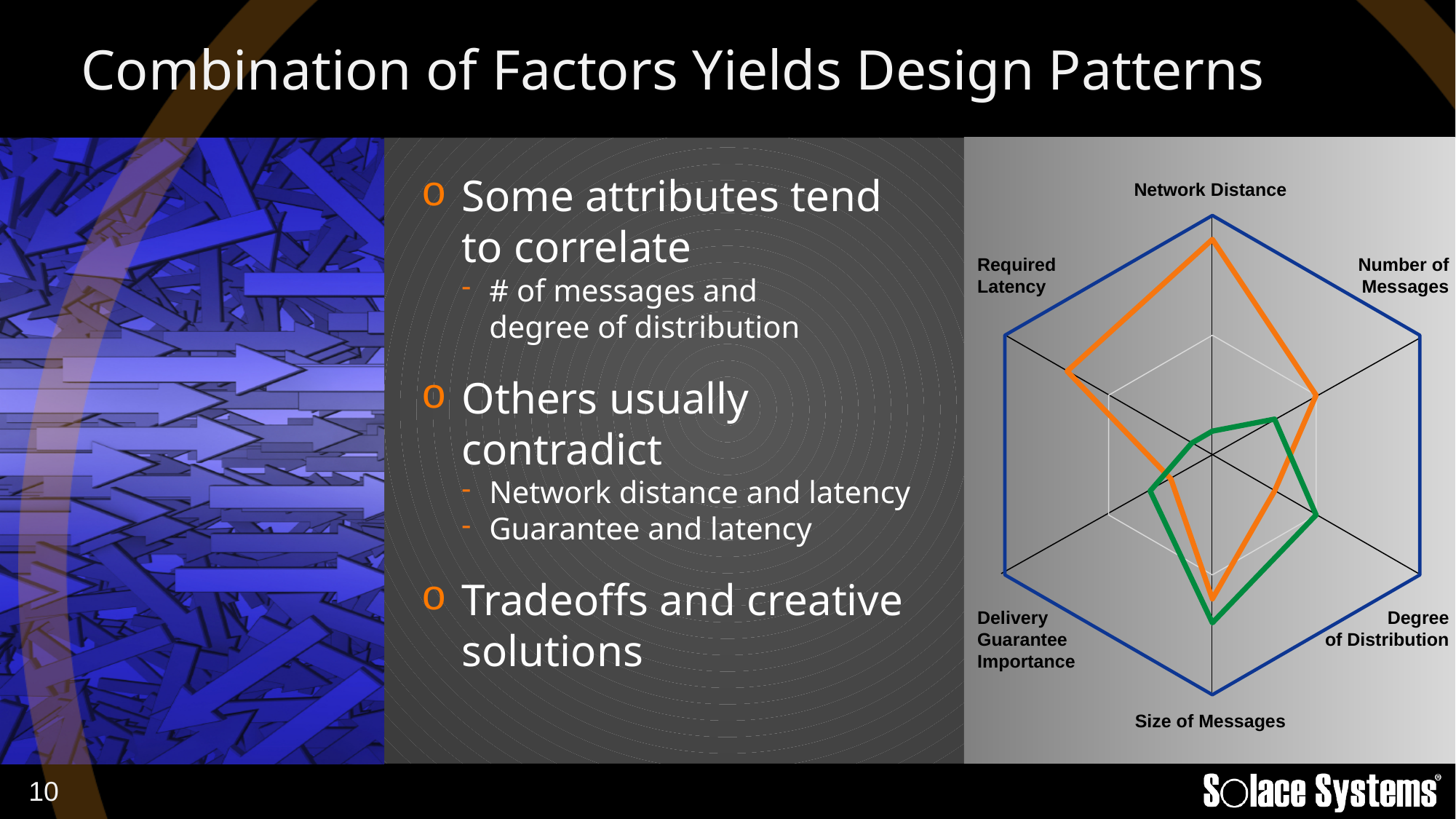
On which axis does the green series have its lowest value? Network Distance and Required Latency (tied) On the Degree of Distribution axis, which series has the larger value, the orange or the green? Green On the Number of Messages axis, which series has the larger value, the orange or the green? Orange On the Required Latency axis, which series has the larger value, the orange or the green? Orange On which axis does the orange series have its lowest value? Delivery Guarantee Importance How many data series are plotted on the radar chart? 3 Which category label appears at the top of the radar chart? Network Distance On which axis does the green series have its highest value? Size of Messages How many axes (categories) does the radar chart have? 6 What kind of chart is shown on the right side of the slide? Radar chart